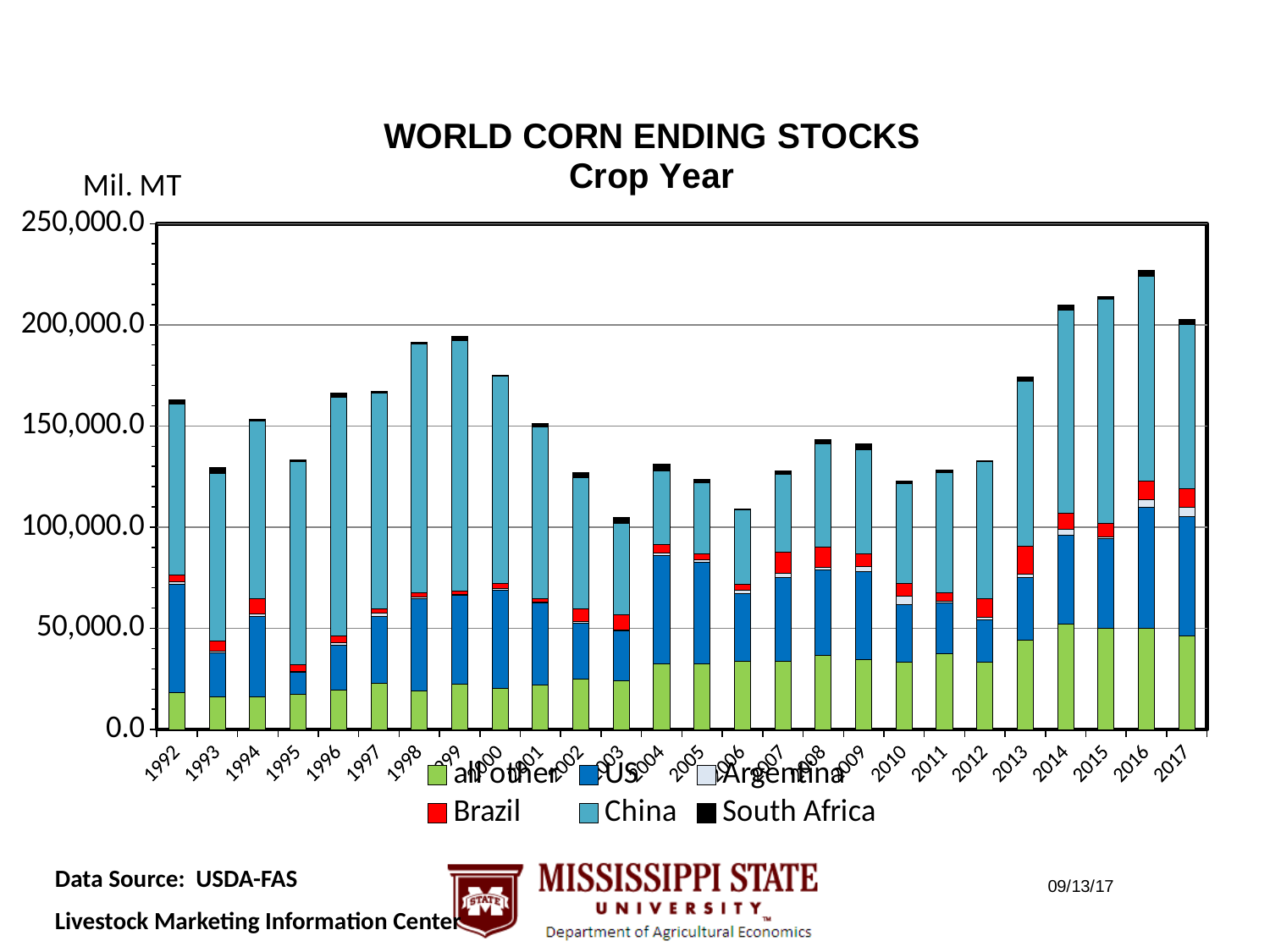
What is the title of the chart? WORLD CORN ENDING STOCKS Crop Year Which has the larger total ending stocks, 1998 or 2003? 1998 Is the total for 1998 greater or less than 150,000? greater Do the total ending stocks rise or fall from 2012 to 2016? rise What kind of chart is shown on the slide? bar chart How many series does the legend list? 6 Is the total for 2016 greater or less than 200,000? greater Which crop year has the highest total world corn ending stocks? 2016 What unit is shown on the y axis label? Mil. MT How many crop years are shown on the x axis? 26 Is the total for 2006 greater or less than 150,000? less